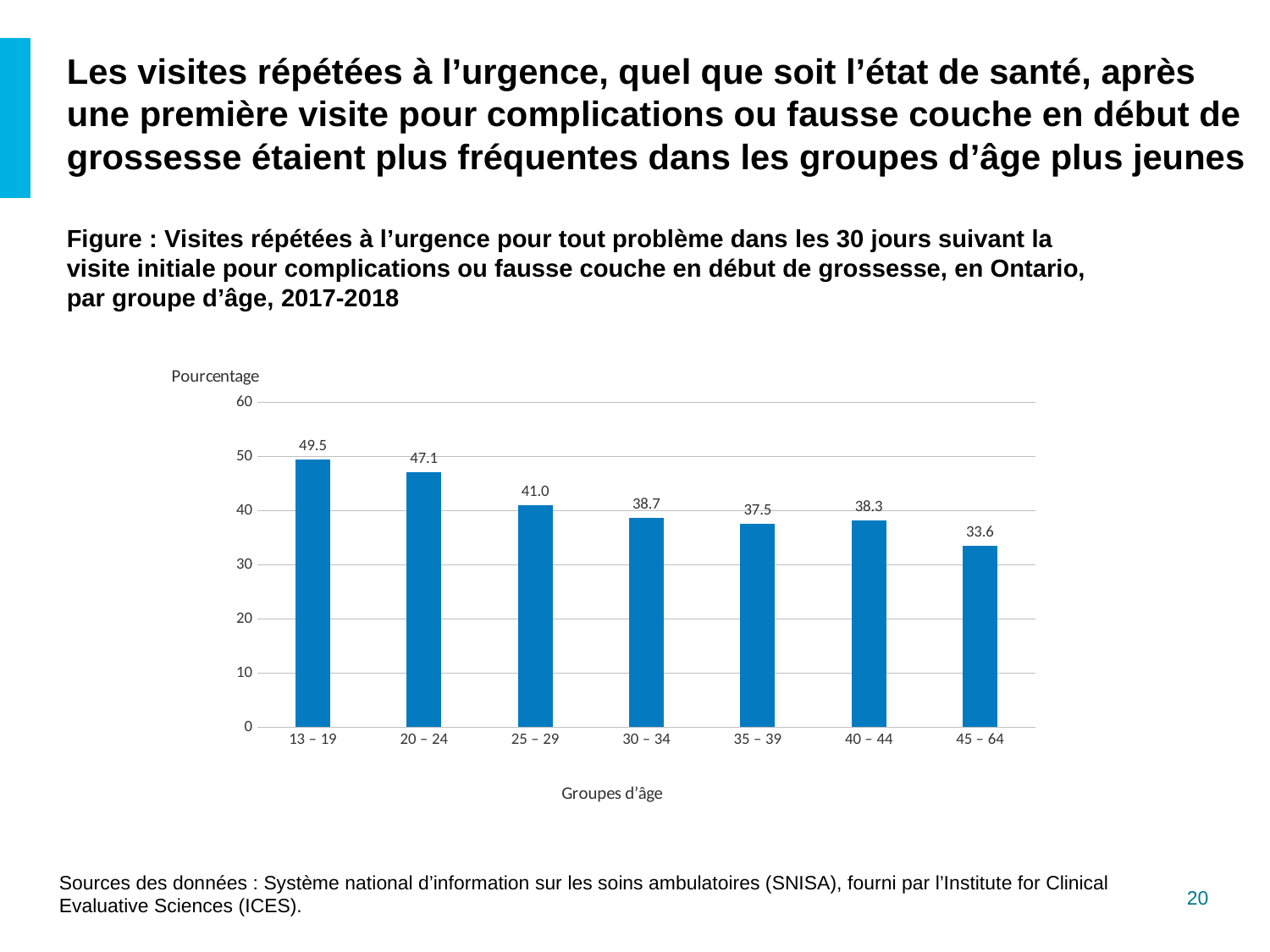
Which age group has the highest value? 13 – 19 What is the value for the 13 – 19 age group? 49.5 What is the difference between the values for the 20 – 24 and 25 – 29 age groups? 6.1 What is the value for the 45 – 64 age group? 33.6 What is the value for the 30 – 34 age group? 38.7 How many age groups are shown on the x axis? 7 What is the difference between the values for the 13 – 19 and 45 – 64 age groups? 15.9 Which age group has the lowest value? 45 – 64 Is the value for the 20 – 24 age group greater or less than 40? greater What kind of chart is shown on the slide? Bar chart Which is larger, the value for 25 – 29 or the value for 35 – 39? 25 – 29 What is the label of the x axis? Groupes d’âge